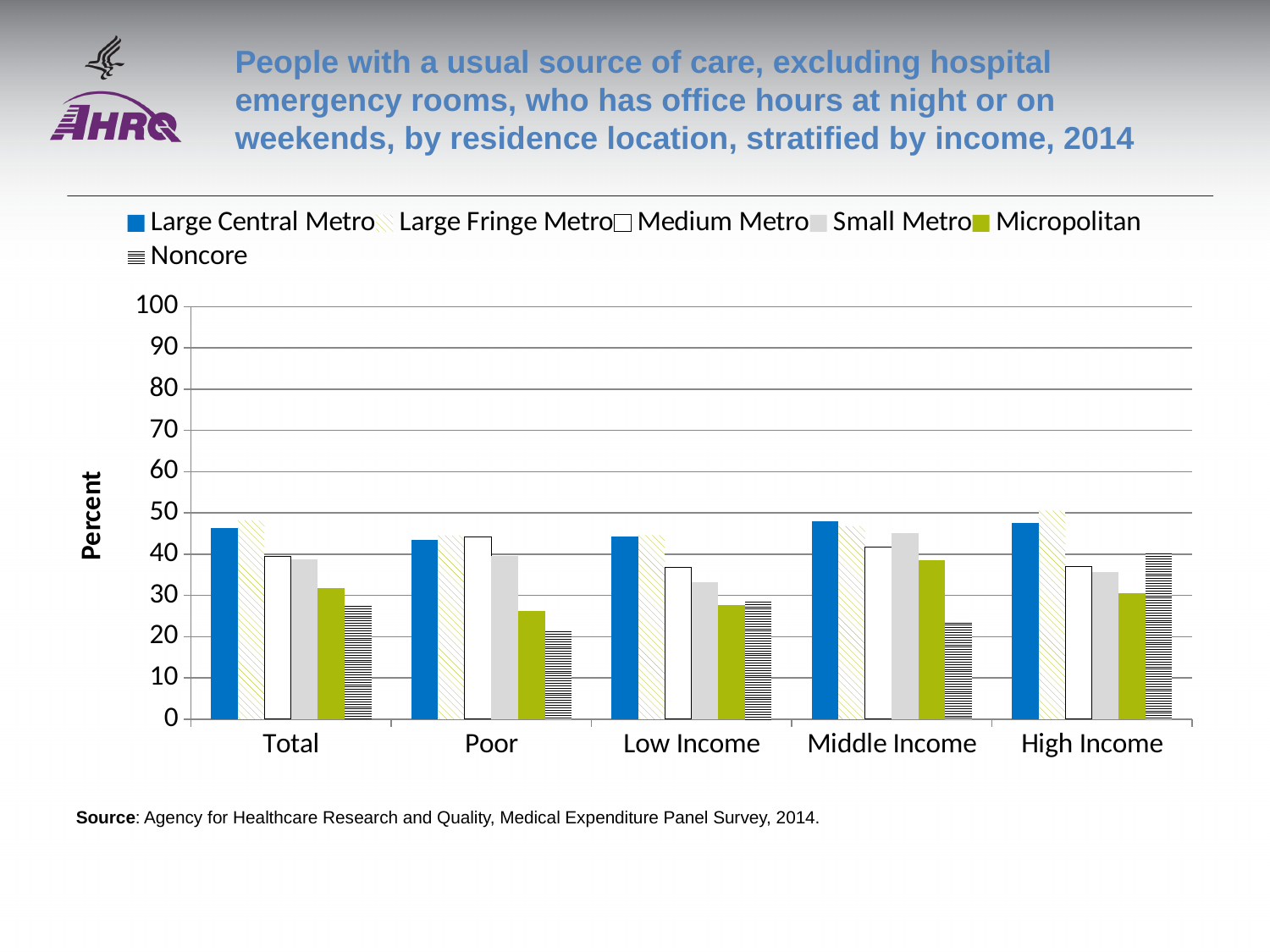
In the High Income group, which is larger: Micropolitan or Noncore? Noncore Is the Noncore value larger in the Total group or in the Poor group? Total How many series does the legend list? 6 Which residence location has the lowest value in the Poor group? Noncore What kind of chart is shown on the slide? bar chart What is the label on the vertical axis? Percent How many income categories are shown along the x axis? 5 Is the value for Large Central Metro in the Middle Income group greater or less than 40? greater Is the value for Noncore in the Poor group greater or less than 30? less Which residence location has the highest value in the High Income group? Large Fringe Metro Is the value for Micropolitan in the Total group greater or less than 40? less Which residence location has the lowest value in the Middle Income group? Noncore